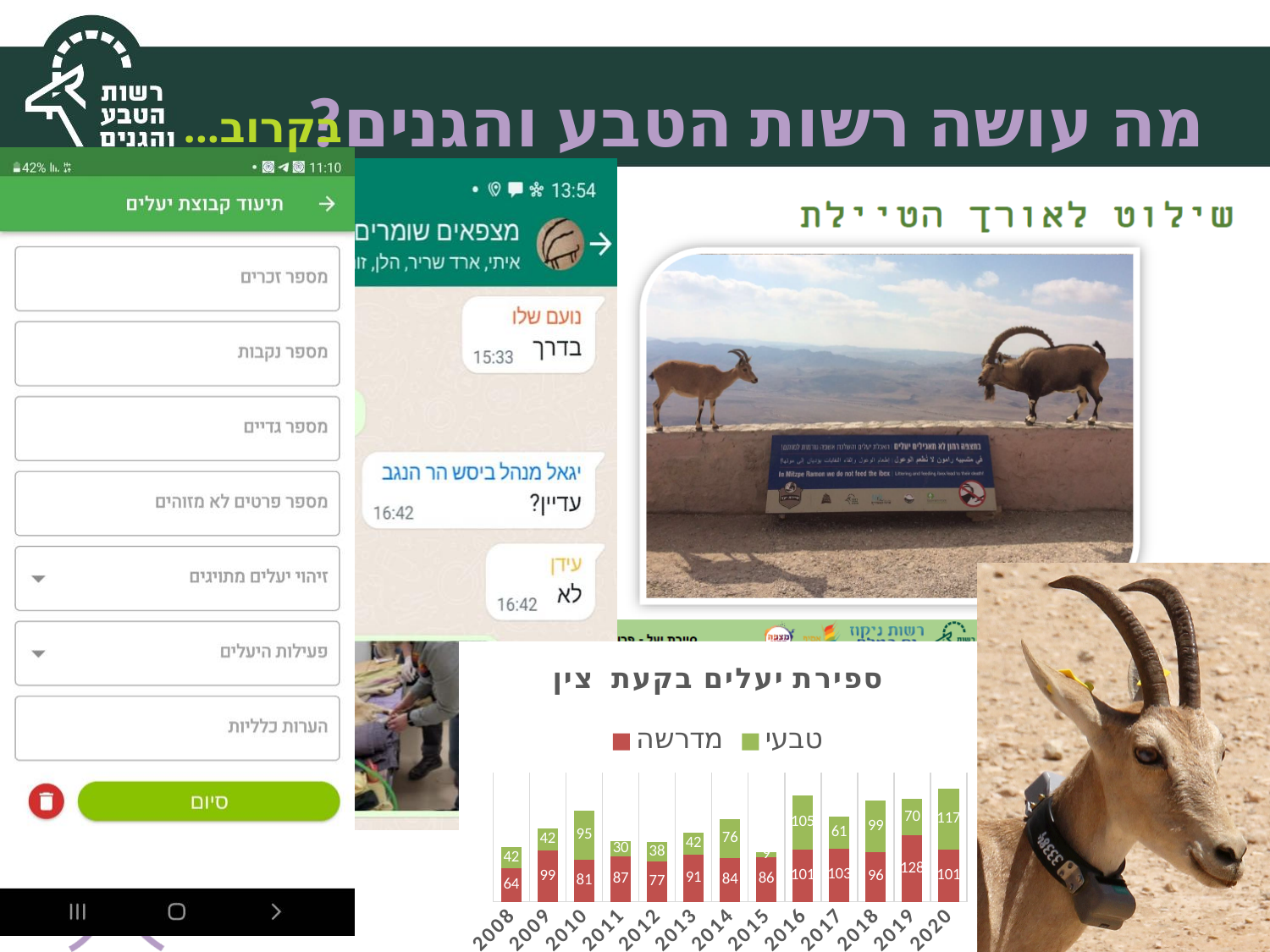
What is the value of טבעי in 2020? 117 In which year is the מדרשה value highest? 2019 What is the total of the stacked bar for 2020? 218 What is the title of the chart on the slide? ספירת יעלים בקעת צין What kind of chart is shown on the slide? stacked bar chart What is the value of מדרשה in 2019? 128 How many years are shown on the x axis of the chart? 13 What is the value of מדרשה in 2008? 64 What is the difference between the מדרשה values in 2019 and 2018? 32 How many series does the chart's legend list? 2 Which is larger, the טבעי value in 2016 or in 2017? 2016 In which year is the מדרשה value lowest? 2008